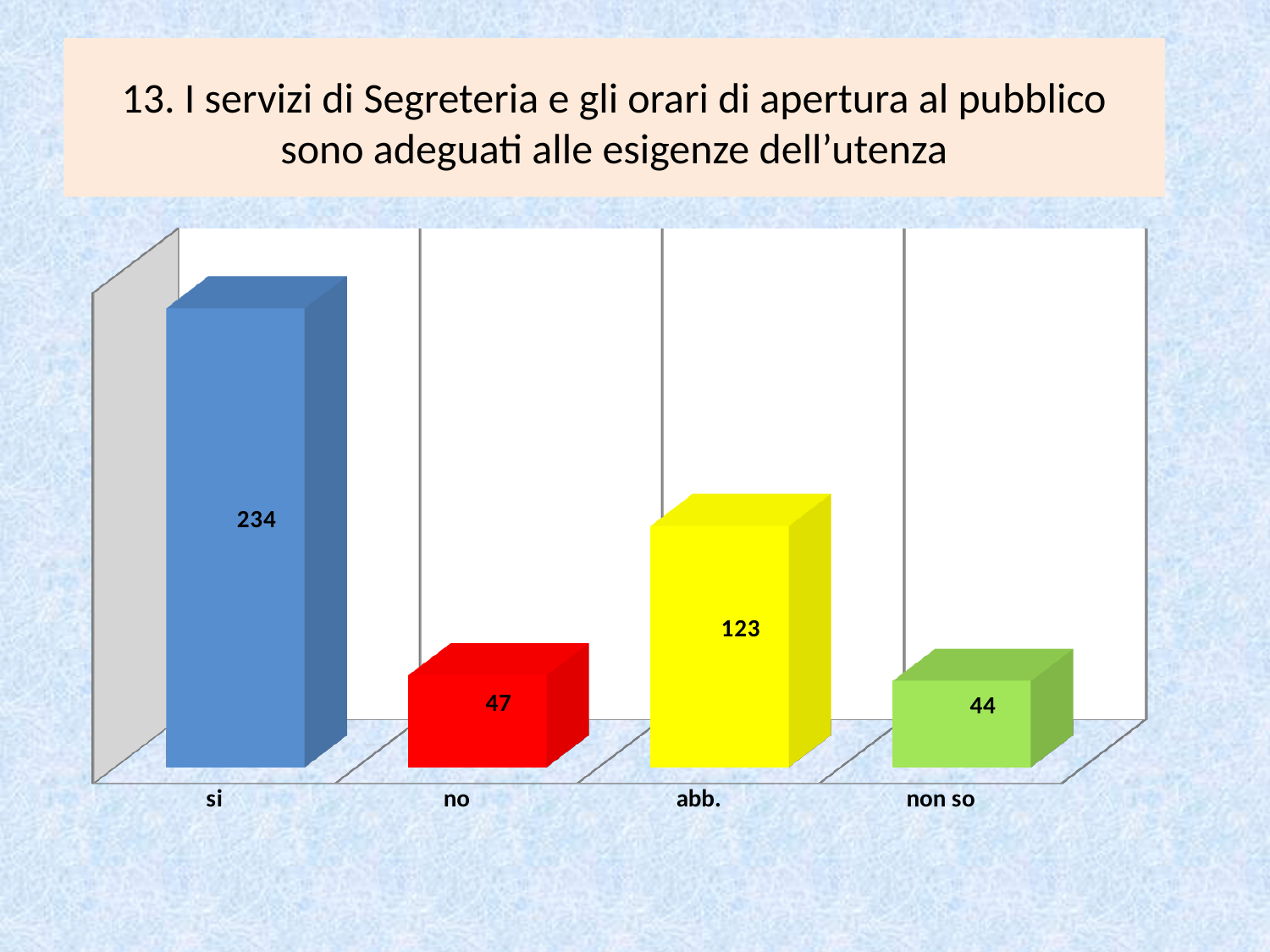
Which category has the highest value? si What is the value for "non so"? 44 What colour is the bar for "abb."? yellow What kind of chart is shown on the slide? bar chart What is the difference between the values for "si" and "abb."? 111 What is the difference between the values for "no" and "non so"? 3 What is the value for "si"? 234 How many categories are shown on the x axis? 4 Which is larger, the value for "abb." or the value for "no"? abb. What is the value for "abb."? 123 Which category has the lowest value? non so What is the value for "no"? 47